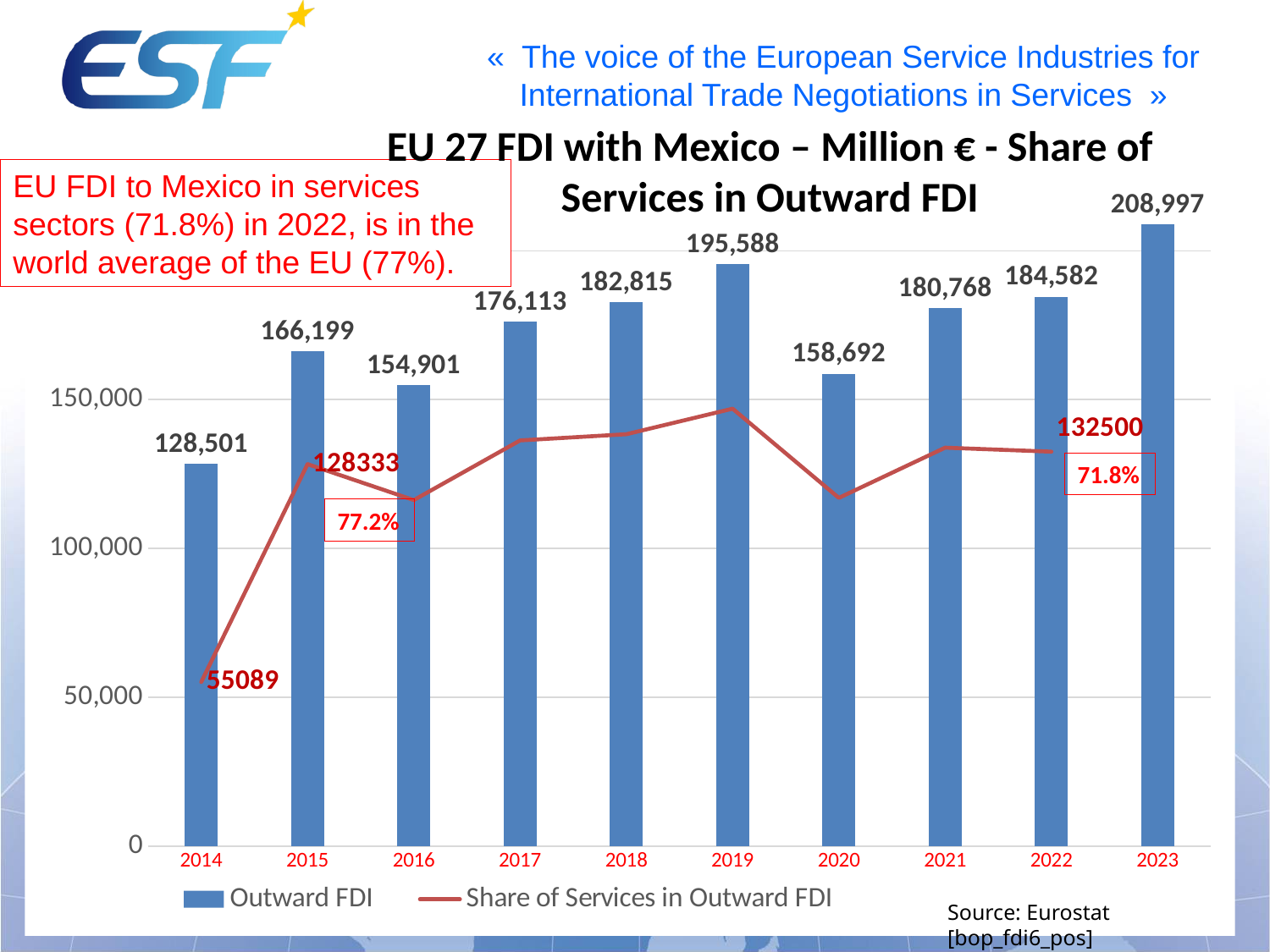
What kind of chart is used to show Outward FDI? bar chart How many series does the legend list? 2 What is the Outward FDI value for 2019? 195,588 Which year has the lowest Outward FDI? 2014 Which year has the highest Outward FDI? 2023 What is the Outward FDI value for 2014? 128,501 How many years are shown on the x axis? 10 Which year has the larger Outward FDI, 2016 or 2020? 2020 What is the labelled value of the Share of Services in Outward FDI line for 2015? 128333 What is the difference between the Outward FDI values for 2023 and 2022? 24,415 Is the Share of Services in Outward FDI line value for 2019 greater or less than 150,000? less What percentage is annotated on the chart for 2022? 71.8%